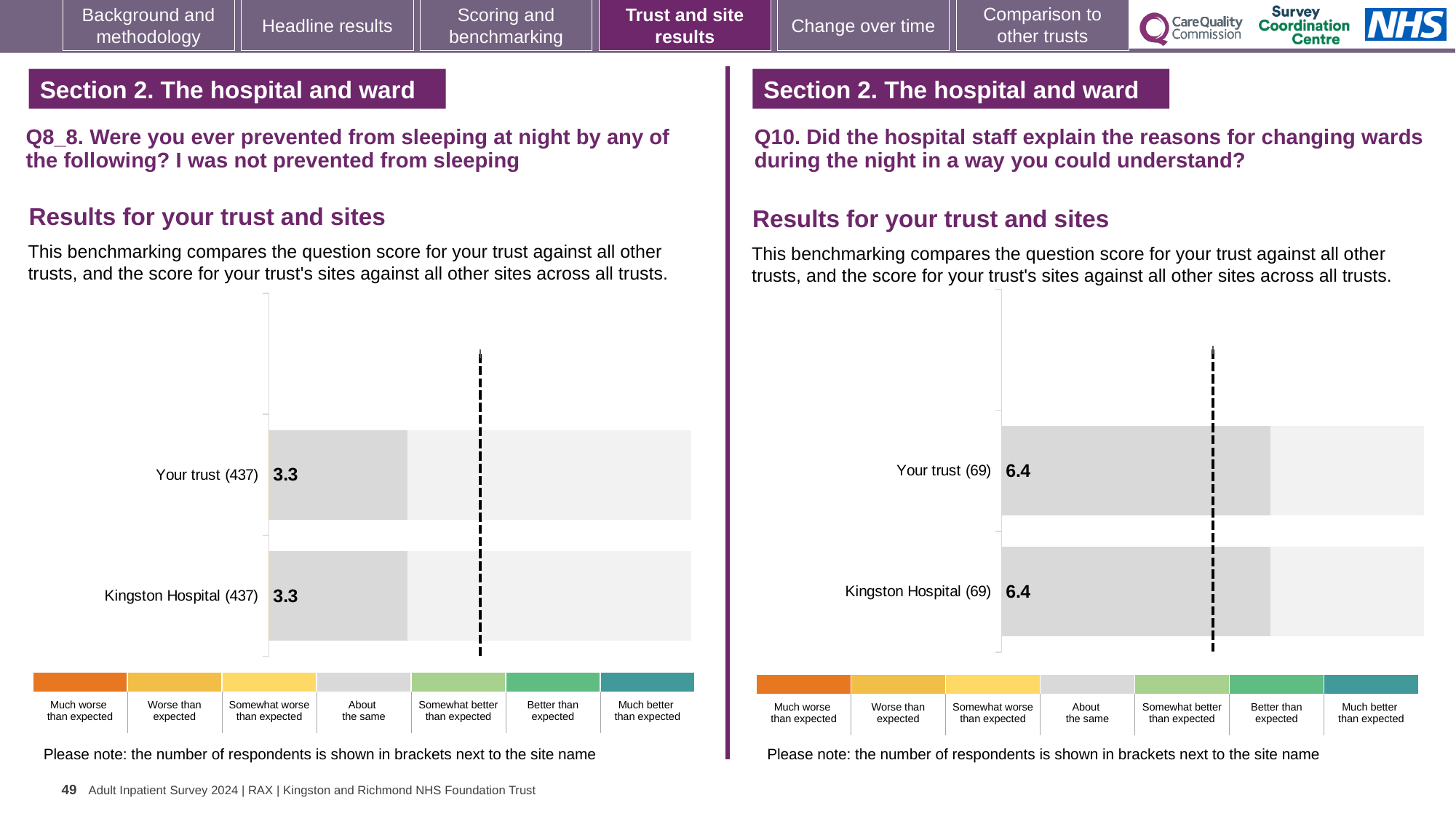
In the Q8_8 chart on the left, what is the score for Your trust (437)? 3.3 Is the score for Your trust in the Q10 chart on the right larger than the score for Your trust in the Q8_8 chart on the left? Yes How many respondents are shown in brackets for Your trust in the Q10 chart on the right? 69 In the Q8_8 chart on the left, which benchmark category does the grey colour of the bars correspond to in the legend? About the same What kind of chart is used in the Q8_8 chart on the left? Bar chart In the Q10 chart on the right, what is the score for Your trust (69)? 6.4 How many bars are plotted in the Q10 chart on the right? 2 How many bars are plotted in the Q8_8 chart on the left? 2 In the Q10 chart on the right, what is the score for Kingston Hospital (69)? 6.4 In the Q8_8 chart on the left, what is the difference between the scores for Your trust and Kingston Hospital? 0.0 In the Q8_8 chart on the left, what is the score for Kingston Hospital (437)? 3.3 In the Q10 chart on the right, what is the difference between the scores for Your trust and Kingston Hospital? 0.0